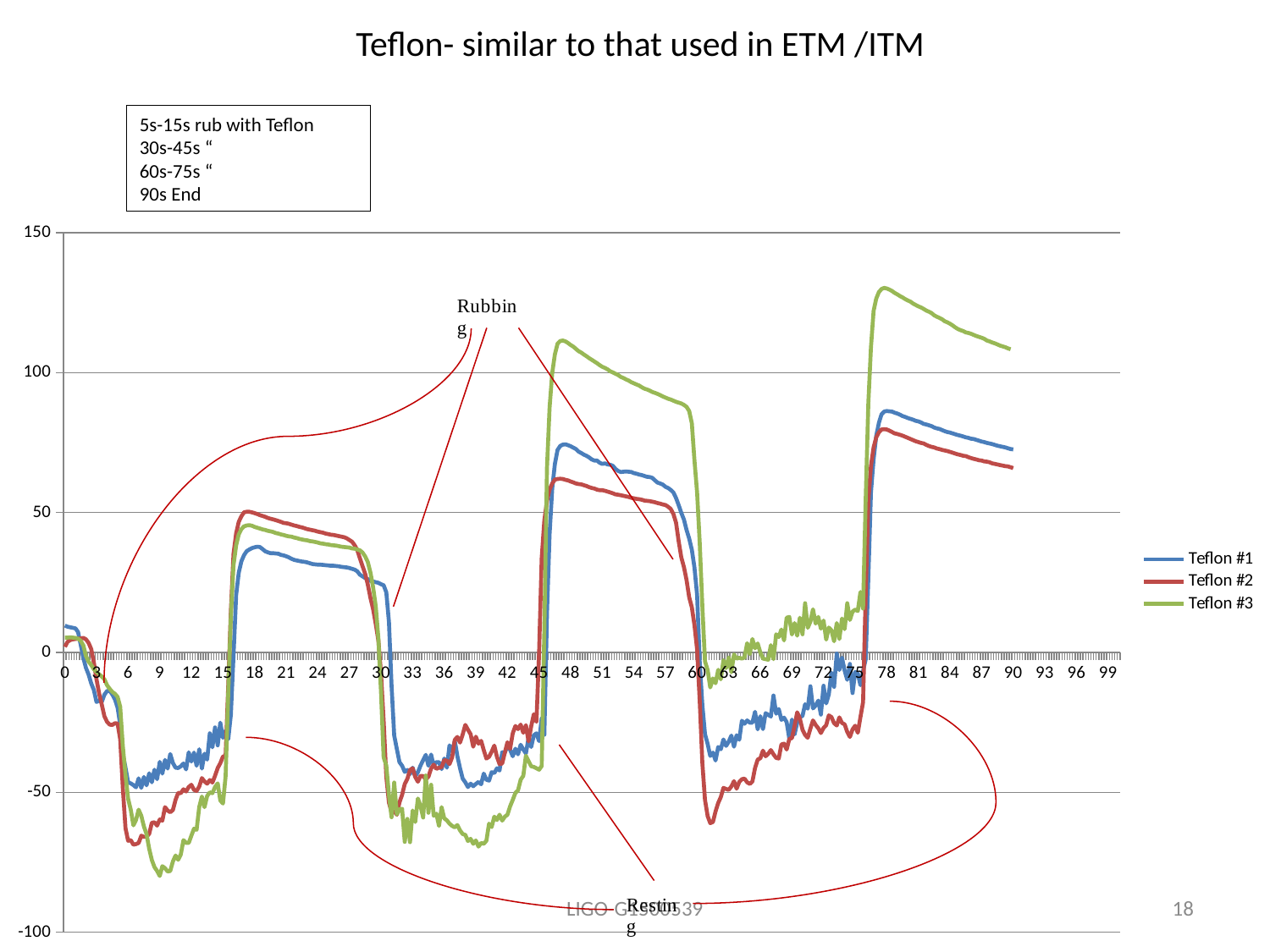
Is the peak value of Teflon #3 near x = 78 greater or less than 100? greater Is the value of Teflon #1 at x = 48 greater or less than 50? greater What is the title of the chart on the slide? Teflon- similar to that used in ETM /ITM Between x = 78 and x = 90, does the Teflon #3 series rise or fall? fall Is the value of Teflon #3 at x = 9 greater or less than -50? less What kind of chart is shown on the slide? line chart Which series reaches the highest value anywhere on the chart? Teflon #3 How many series does the legend list? 3 Which colour is used for the Teflon #3 series? green At x = 9, which series has the larger value, Teflon #1 or Teflon #3? Teflon #1 At x = 78, which series has the larger value, Teflon #3 or Teflon #1? Teflon #3